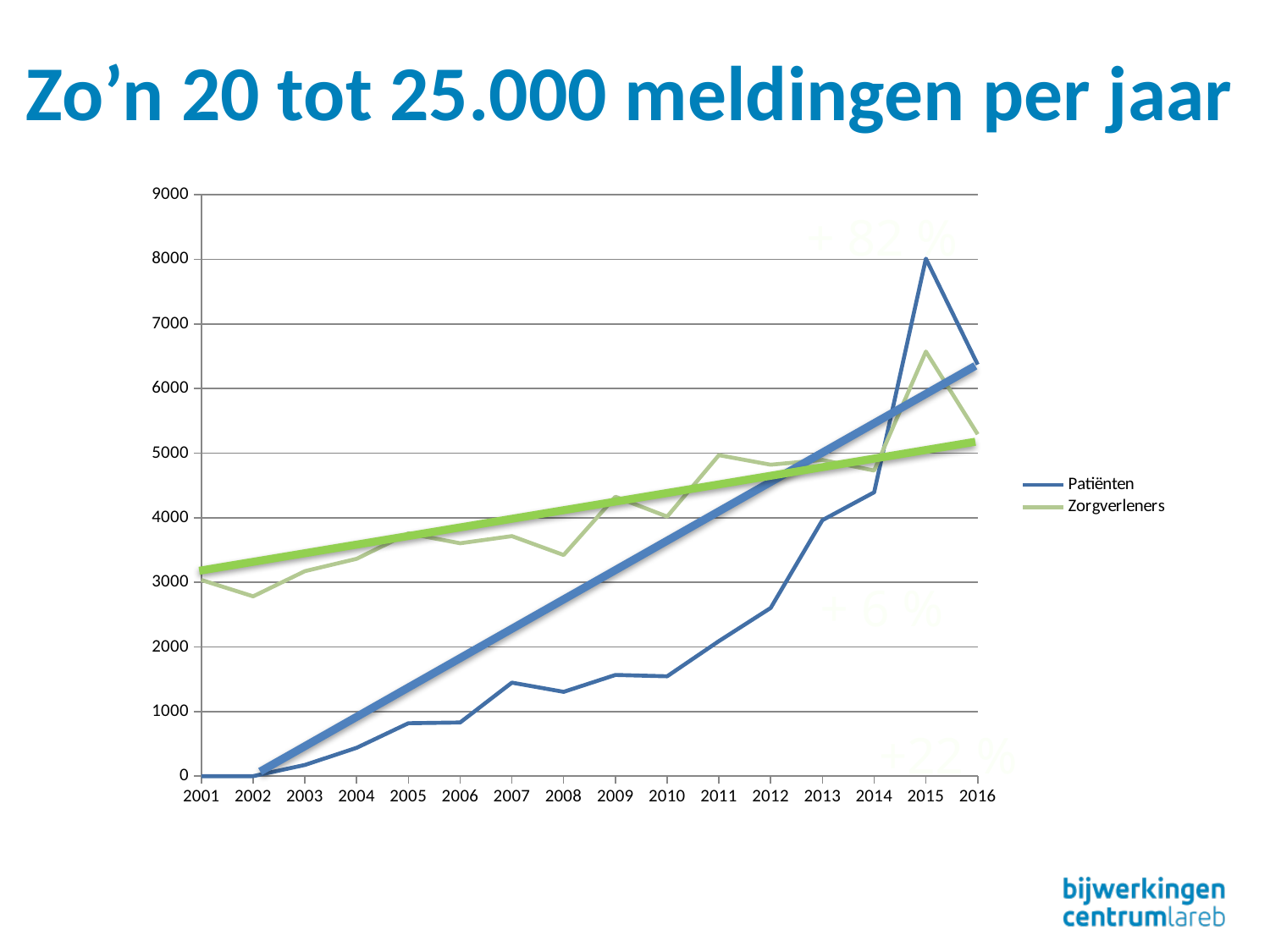
In 2010, which series has the larger value, Patiënten or Zorgverleners? Zorgverleners Does the Patiënten series generally rise or fall from 2001 to 2015? rise In which year is the Zorgverleners series at its lowest? 2002 Is the value for Patiënten in 2012 greater or less than 3000? less How many years are shown on the x axis? 16 Is the value for Zorgverleners in 2002 greater or less than 3000? less In which year does the Zorgverleners series reach its highest value? 2015 What are the two series named in the legend? Patiënten and Zorgverleners What kind of chart is shown on the slide? line chart Is the value for Patiënten in 2015 greater or less than 7000? greater In which year does the Patiënten series reach its highest value? 2015 How many series does the legend list? 2